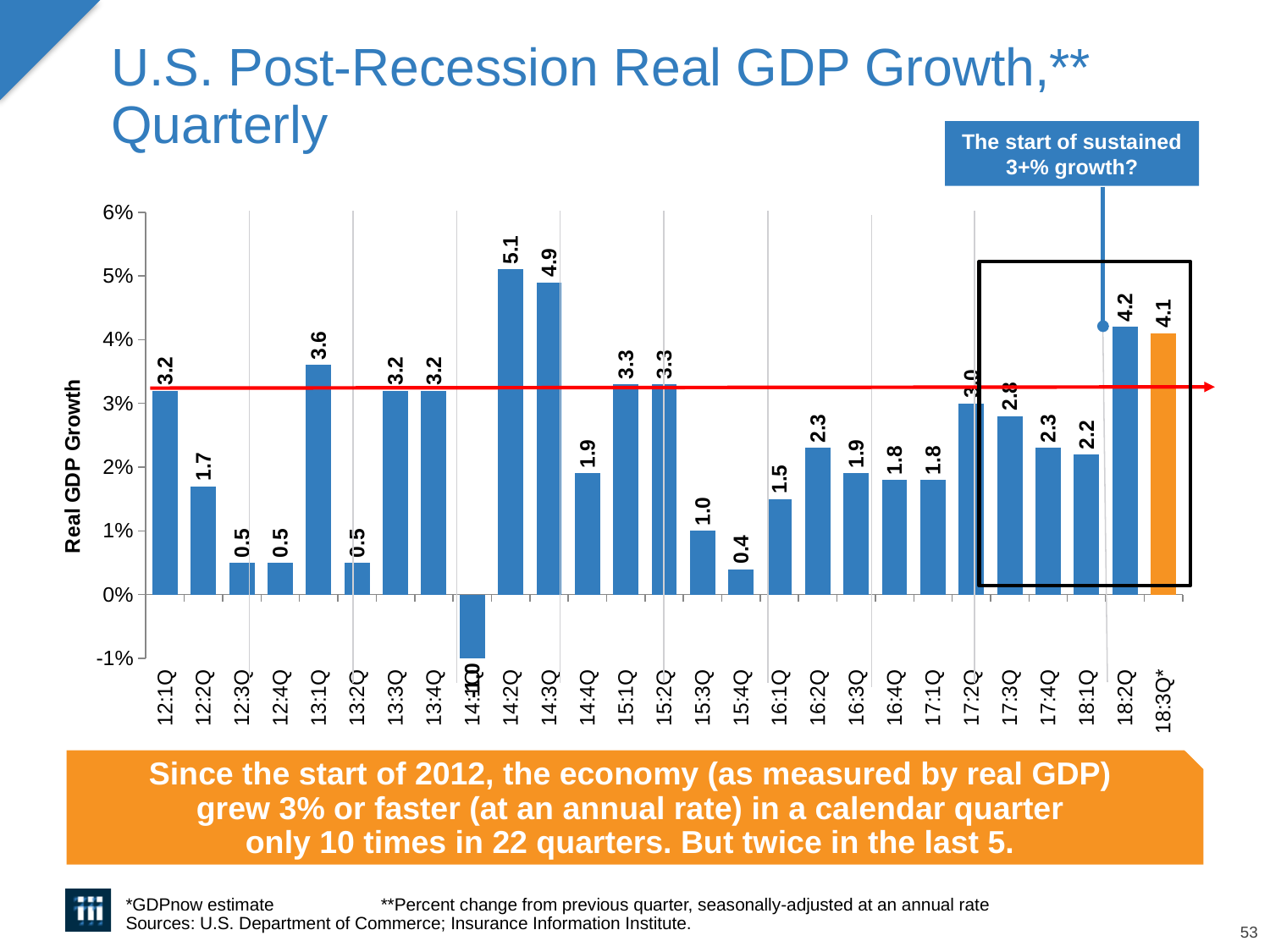
Which quarter has the lowest real GDP growth? 14:1Q Which quarter's bar is colored orange instead of blue? 18:3Q* Is the value for 14:1Q greater or less than 0%? less What is the real GDP growth value for 18:2Q? 4.2 What is the real GDP growth value for 13:1Q? 3.6 What kind of chart is shown on the slide? bar chart What is the difference between the values for 18:2Q and 18:1Q? 2.0 Which is larger, the value for 12:2Q or the value for 16:2Q? 16:2Q Which quarter has the highest real GDP growth? 14:2Q How many quarters are plotted on the chart? 27 What is the difference between the values for 14:2Q and 14:3Q? 0.2 What is the real GDP growth value for 15:4Q? 0.4